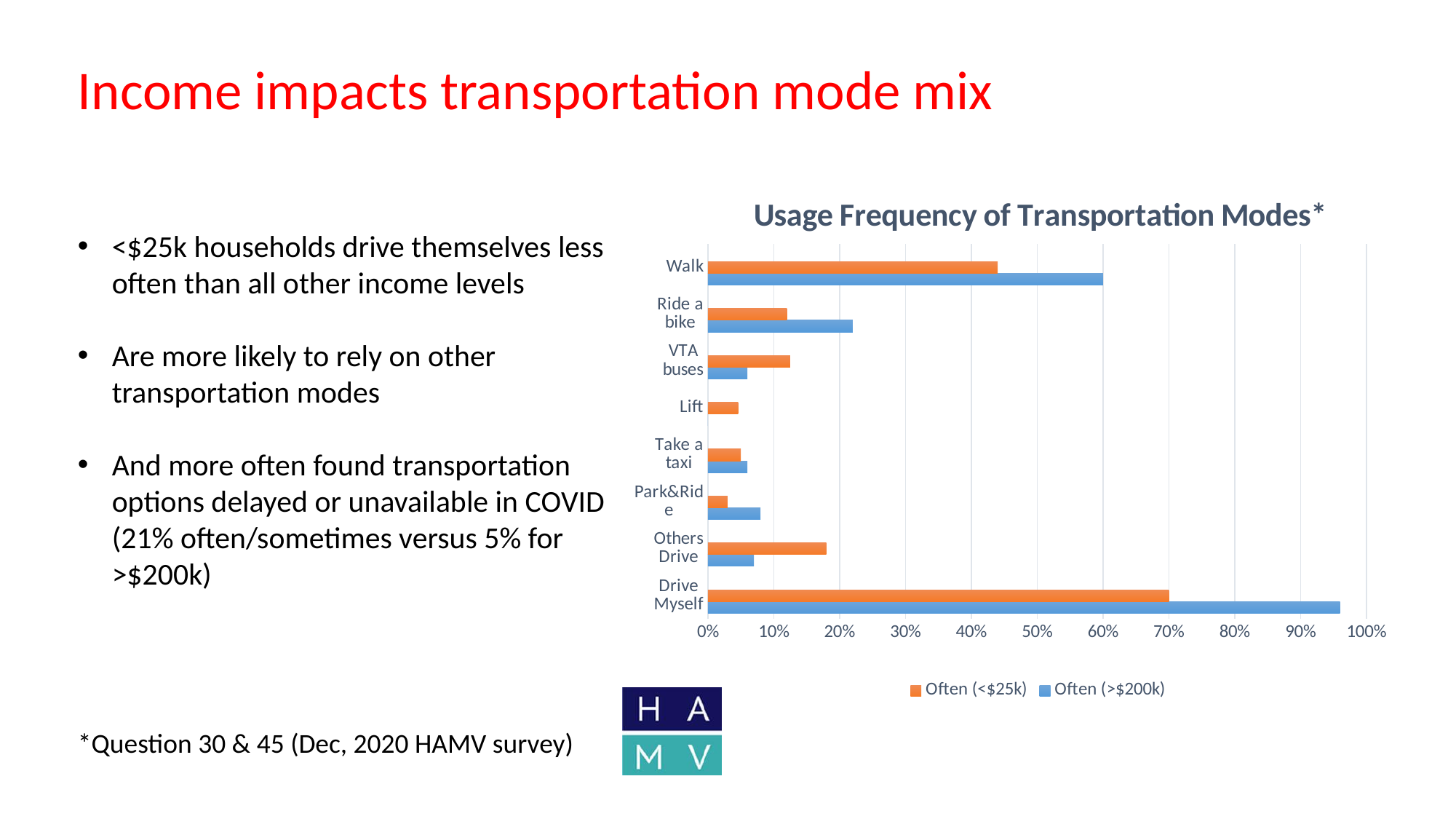
How many series does the chart legend list? 2 How many transportation mode categories are shown on the chart? 8 Is the Often (>$200k) value for Ride a bike greater or less than 20%? greater For Others Drive, which series has the larger value, Often (<$25k) or Often (>$200k)? Often (<$25k) Which transportation mode has the highest value for the Often (<$25k) series? Drive Myself What type of chart is shown on the slide? bar chart For Walk, which series has the larger value, Often (<$25k) or Often (>$200k)? Often (>$200k) Which transportation mode has the highest value for the Often (>$200k) series? Drive Myself What is the title of the chart? Usage Frequency of Transportation Modes* Is the Often (<$25k) value for Walk greater or less than 50%? less Which colour represents the Often (<$25k) series in the chart? orange Is the Often (>$200k) value for Drive Myself greater or less than 90%? greater